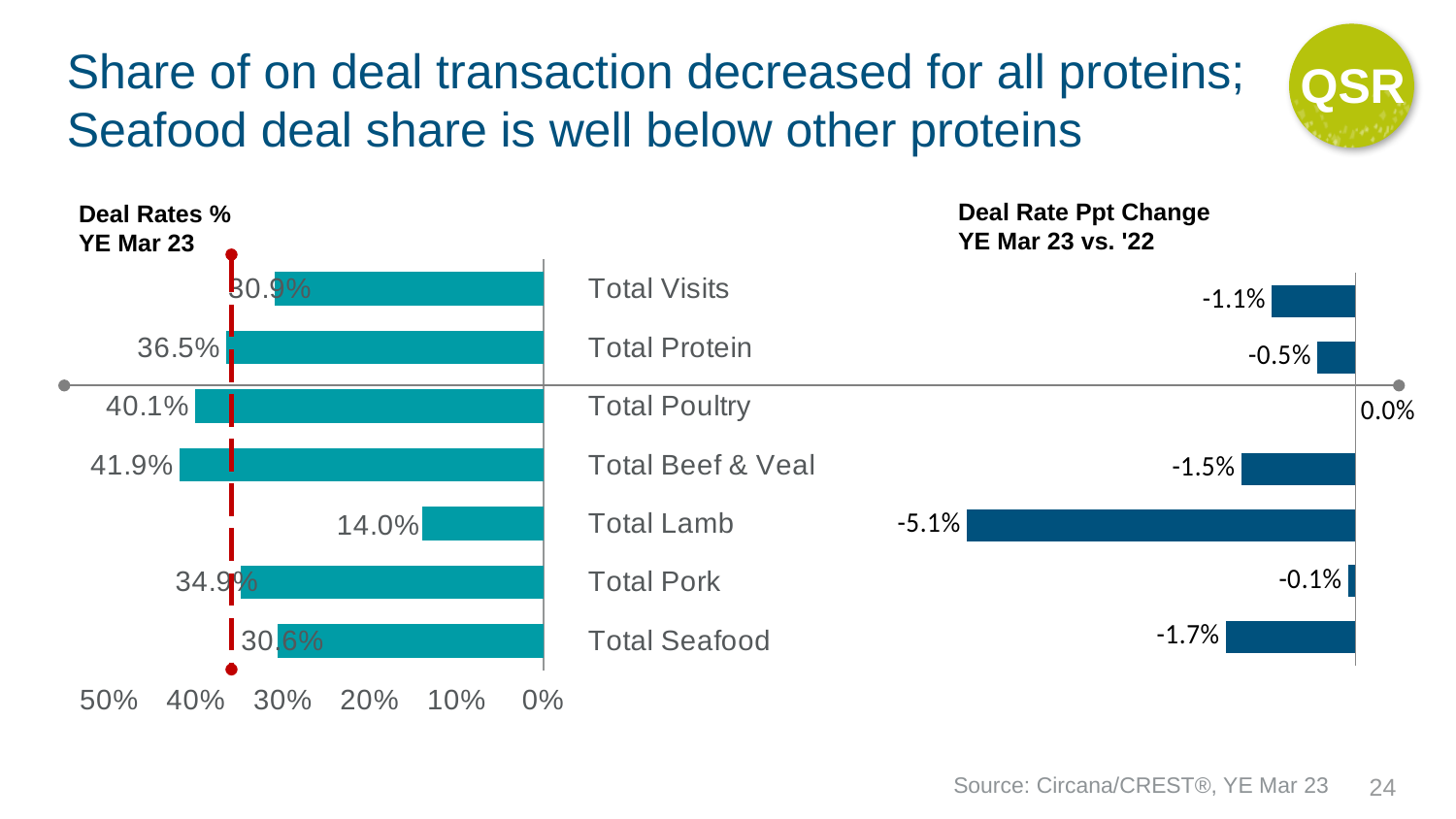
In the Deal Rates % YE Mar 23 chart, which has a higher deal rate, Total Protein or Total Pork? Total Protein In the Deal Rate Ppt Change YE Mar 23 vs. '22 chart, what is the value for Total Seafood? -1.7% In the Deal Rates % YE Mar 23 chart, what is the deal rate for Total Lamb? 14.0% In the Deal Rate Ppt Change YE Mar 23 vs. '22 chart, what is the value for Total Lamb? -5.1% In the Deal Rate Ppt Change YE Mar 23 vs. '22 chart, which category shows the largest decrease? Total Lamb In the Deal Rates % YE Mar 23 chart, which category has the lowest deal rate? Total Lamb How many categories are shown in the Deal Rates % YE Mar 23 chart? 7 What type of chart is the Deal Rate Ppt Change YE Mar 23 vs. '22 chart? Bar chart In the Deal Rates % YE Mar 23 chart, which category has the highest deal rate? Total Beef & Veal In the Deal Rates % YE Mar 23 chart, what is the difference between the deal rates for Total Poultry and Total Lamb? 26.1% In the Deal Rates % YE Mar 23 chart, what is the deal rate for Total Beef & Veal? 41.9% In the Deal Rate Ppt Change YE Mar 23 vs. '22 chart, what is the value for Total Poultry? 0.0%